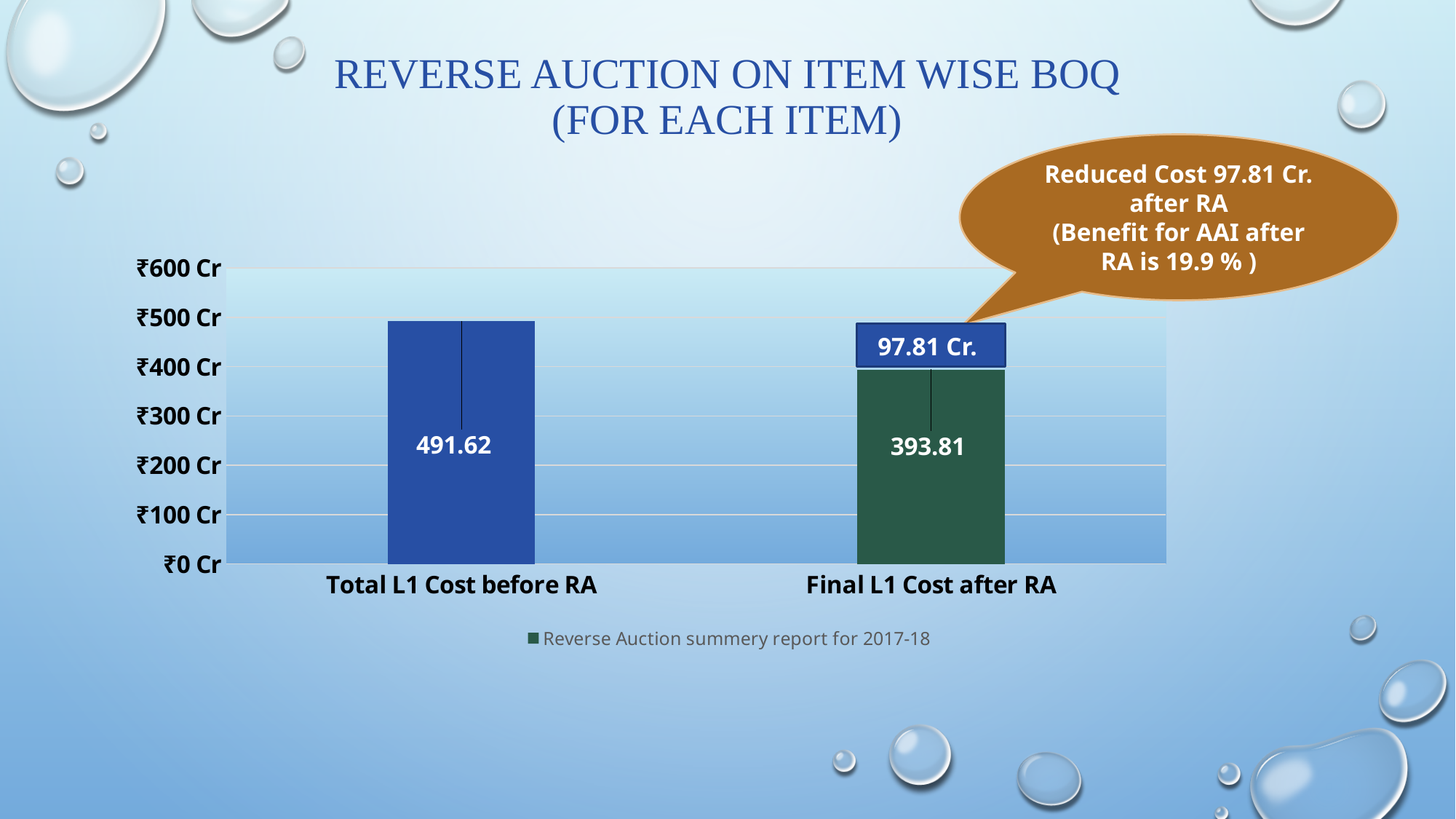
Is the value for Total L1 Cost before RA greater or less than ₹400 Cr? greater Which is larger, Total L1 Cost before RA or Final L1 Cost after RA? Total L1 Cost before RA What is the value for Total L1 Cost before RA? 491.62 Which category has the highest value? Total L1 Cost before RA What kind of chart is shown on the slide? bar chart How many series does the legend list? 1 Which category has the lowest value? Final L1 Cost after RA Is the value for Final L1 Cost after RA greater or less than ₹400 Cr? less What is the difference between Total L1 Cost before RA and Final L1 Cost after RA? 97.81 How many categories are shown on the x axis? 2 What is the value for Final L1 Cost after RA? 393.81 What is the legend entry of the chart? Reverse Auction summery report for 2017-18